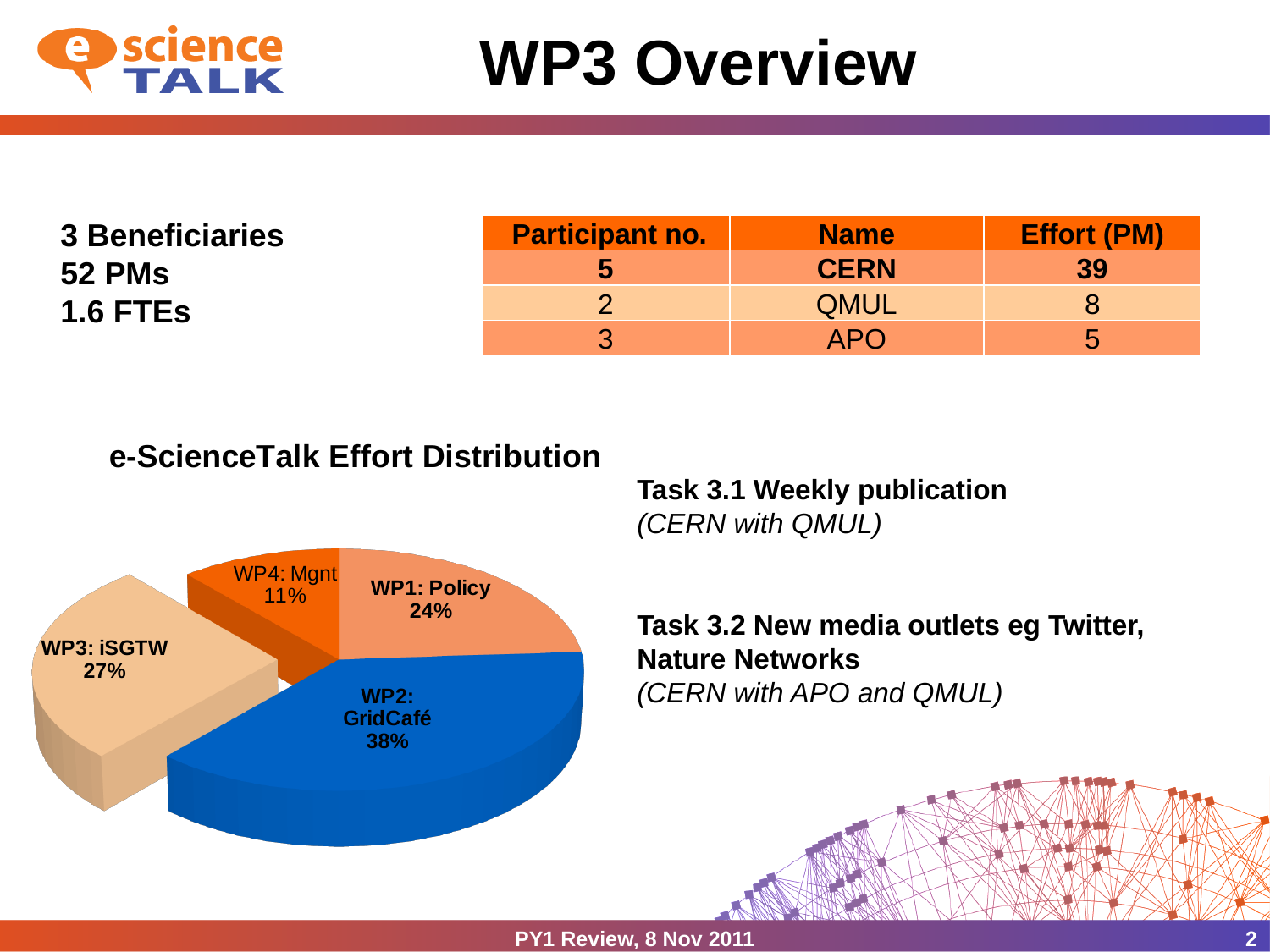
Which work package has the largest slice in the pie chart? WP2: GridCafé What share of effort does WP3: iSGTW have in the pie chart? 27% How many slices does the pie chart have? 4 What share of effort does WP1: Policy have in the pie chart? 24% What kind of chart is the e-ScienceTalk Effort Distribution chart? pie chart Which work package has the smallest slice in the pie chart? WP4: Mgnt What colour is the WP2: GridCafé slice in the pie chart? blue What share of effort does WP2: GridCafé have in the pie chart? 38% What is the difference in percentage points between WP2: GridCafé and WP3: iSGTW in the pie chart? 11 Which has a larger share in the pie chart, WP1: Policy or WP3: iSGTW? WP3: iSGTW What is the title of the pie chart? e-ScienceTalk Effort Distribution